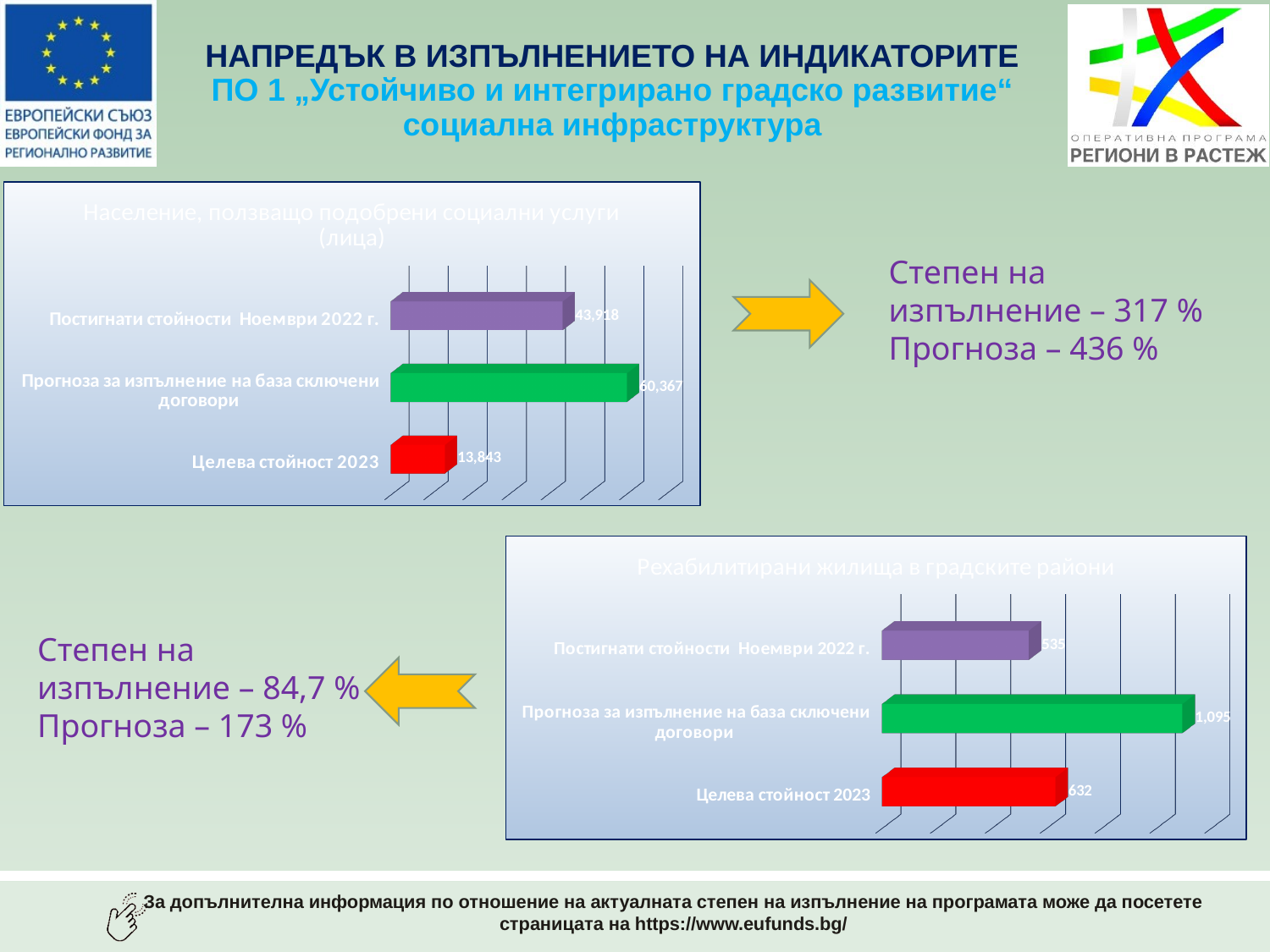
In the top-left chart (Население, ползващо подобрени социални услуги), what is the value for Прогноза за изпълнение на база сключени договори? 60,367 In the bottom-right chart (Рехабилитирани жилища в градските райони), which is larger: Целева стойност 2023 or Постигнати стойности Ноември 2022 г.? Целева стойност 2023 In the bottom-right chart (Рехабилитирани жилища в градските райони), what is the value for Постигнати стойности Ноември 2022 г.? 535 In the bottom-right chart (Рехабилитирани жилища в градските райони), what is the value for Целева стойност 2023? 632 In the top-left chart (Население, ползващо подобрени социални услуги), what is the value for Постигнати стойности Ноември 2022 г.? 43,918 In the top-left chart (Население, ползващо подобрени социални услуги), which category has the highest value? Прогноза за изпълнение на база сключени договори In the top-left chart (Население, ползващо подобрени социални услуги), what is the value for Целева стойност 2023? 13,843 In the bottom-right chart (Рехабилитирани жилища в градските райони), what is the value for Прогноза за изпълнение на база сключени договори? 1,095 What type of chart is the bottom-right chart (Рехабилитирани жилища в градските райони)? Bar chart In the bottom-right chart (Рехабилитирани жилища в градските райони), what is the difference between Целева стойност 2023 and Постигнати стойности Ноември 2022 г.? 97 In the top-left chart (Население, ползващо подобрени социални услуги), which category has the lowest value? Целева стойност 2023 In the top-left chart (Население, ползващо подобрени социални услуги), what is the difference between Прогноза за изпълнение на база сключени договори and Постигнати стойности Ноември 2022 г.? 16,449